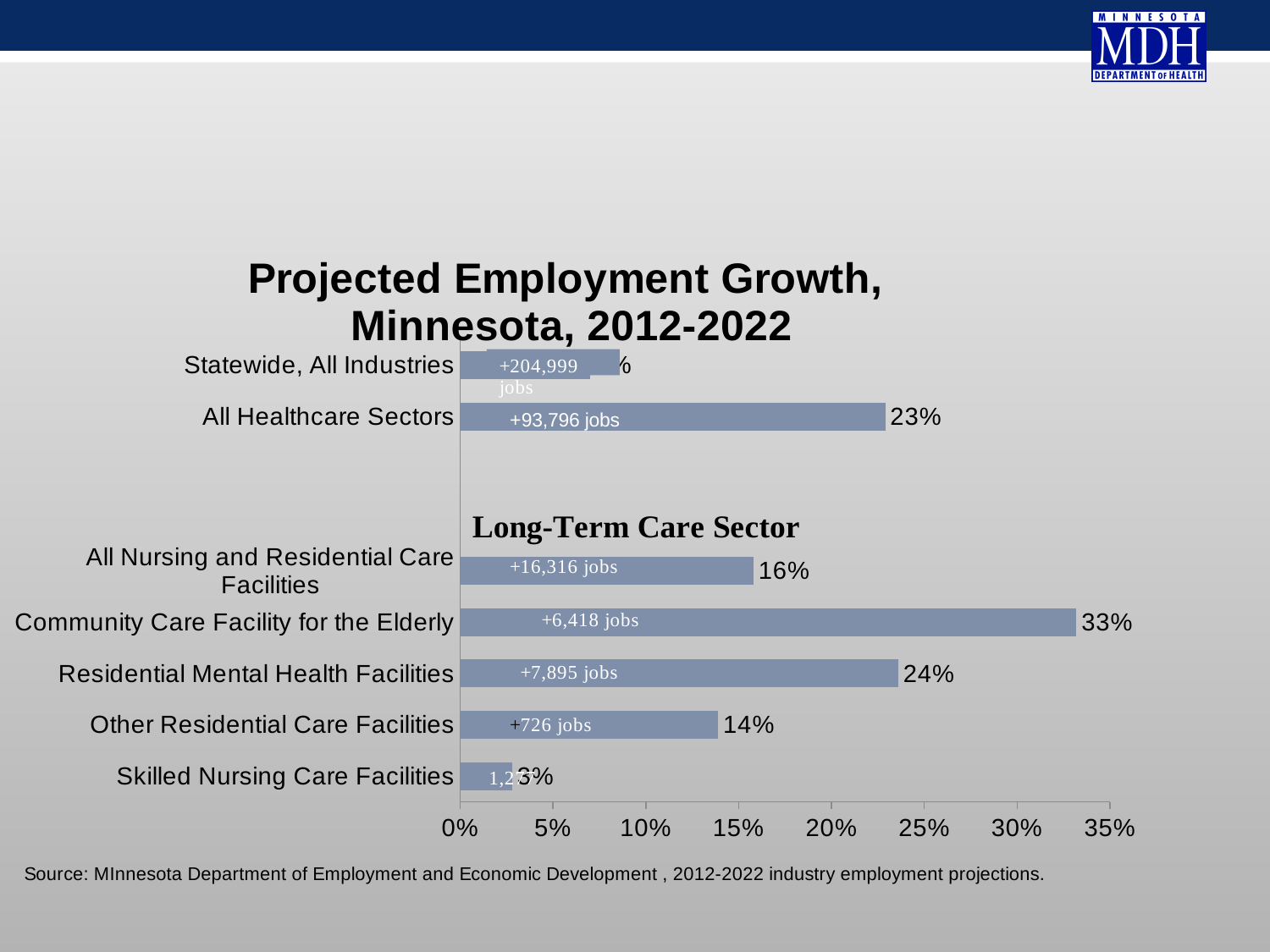
What is the projected employment growth for Community Care Facility for the Elderly? 33% How many jobs are projected to be added in All Healthcare Sectors, according to the bar label? +93,796 jobs What is the projected employment growth for Residential Mental Health Facilities? 24% What is the projected employment growth for Other Residential Care Facilities? 14% Which category has the lowest projected employment growth? Skilled Nursing Care Facilities How many categories are plotted in the chart? 7 What is the projected employment growth for All Healthcare Sectors? 23% Which category has the highest projected employment growth? Community Care Facility for the Elderly Is the projected growth for Statewide, All Industries greater or less than 10%? less Which has higher projected growth: Residential Mental Health Facilities or All Nursing and Residential Care Facilities? Residential Mental Health Facilities What type of chart is shown on the slide? Bar chart What is the difference in projected growth between Community Care Facility for the Elderly and All Healthcare Sectors? 10 percentage points